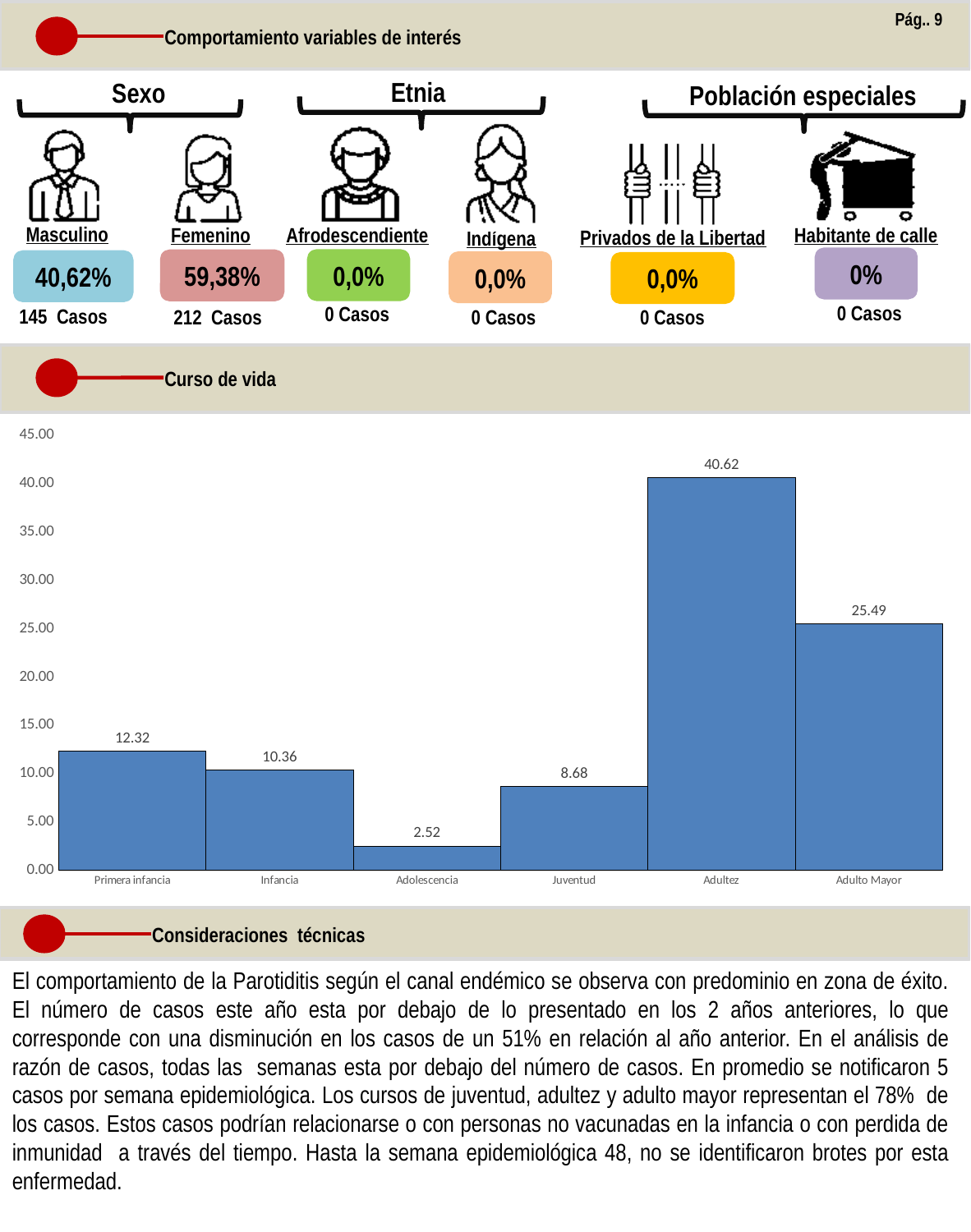
In the Curso de vida chart, which category has the lowest value? Adolescencia In the Curso de vida chart, is the value for Adulto Mayor greater or less than 20.00? greater How many categories are shown on the x axis of the Curso de vida chart? 6 In the Curso de vida chart, what is the value for Adultez? 40.62 In the Curso de vida chart, what is the value for Adulto Mayor? 25.49 In the Curso de vida chart, what is the value for Primera infancia? 12.32 In the Curso de vida chart, what is the difference between the values for Adultez and Adulto Mayor? 15.13 In the Curso de vida chart, which is larger, the value for Infancia or the value for Juventud? Infancia In the Curso de vida chart, which category has the highest value? Adultez What kind of chart is shown in the Curso de vida section? Bar chart In the Curso de vida chart, what is the value for Adolescencia? 2.52 In the Curso de vida chart, what is the difference between the values for Primera infancia and Infancia? 1.96